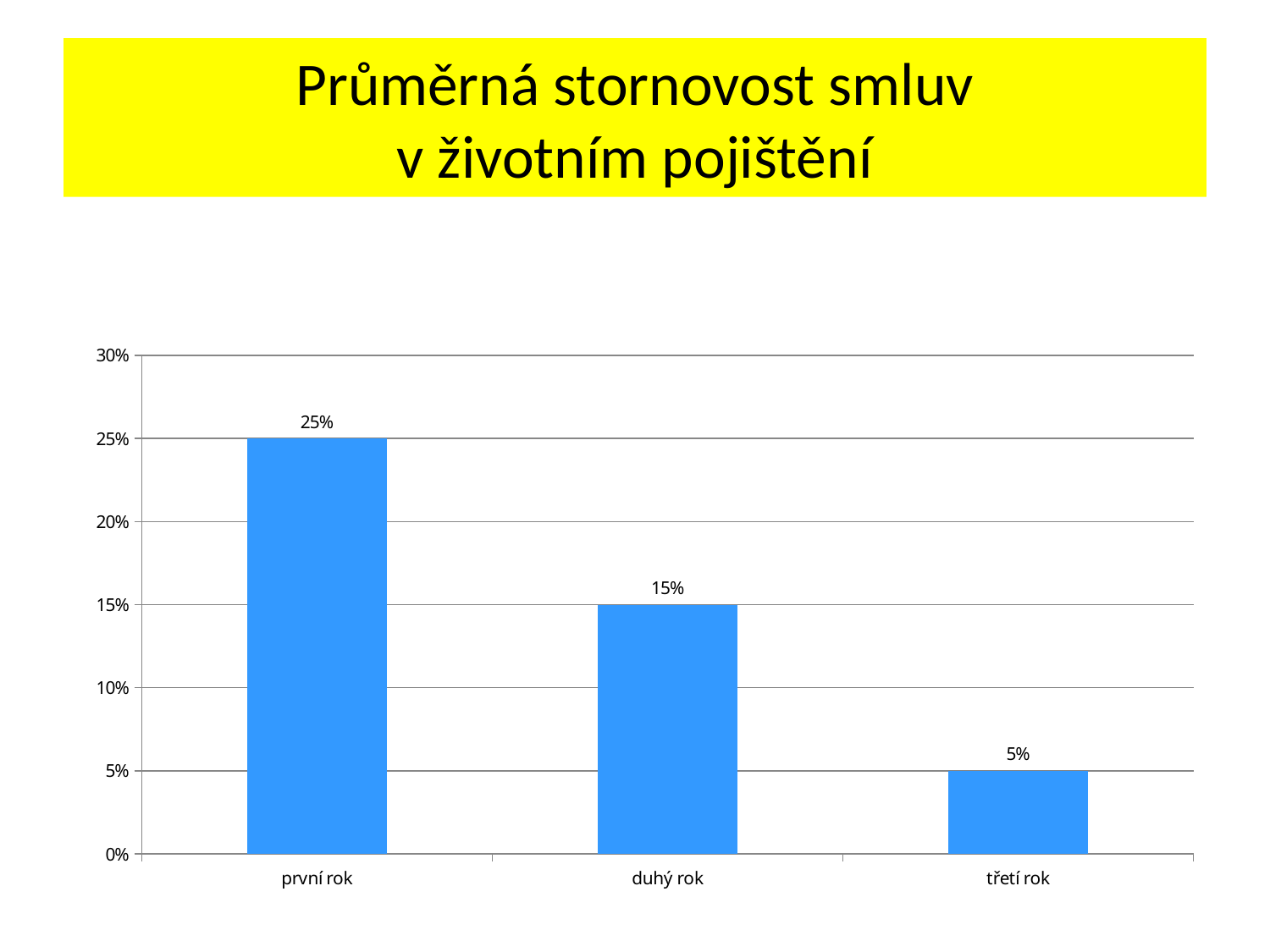
Do the values rise or fall from první rok to třetí rok? fall What is the value for třetí rok? 5% Which category has the lowest value? třetí rok How many categories are shown on the x axis? 3 Which category has the highest value? první rok What is the difference between the values for první rok and duhý rok? 10% Which is larger, the value for duhý rok or the value for třetí rok? duhý rok What is the difference between the values for první rok and třetí rok? 20% What is the value for první rok? 25% Is the value for duhý rok greater or less than 20%? less What is the value for duhý rok? 15% What kind of chart is shown on the slide? bar chart